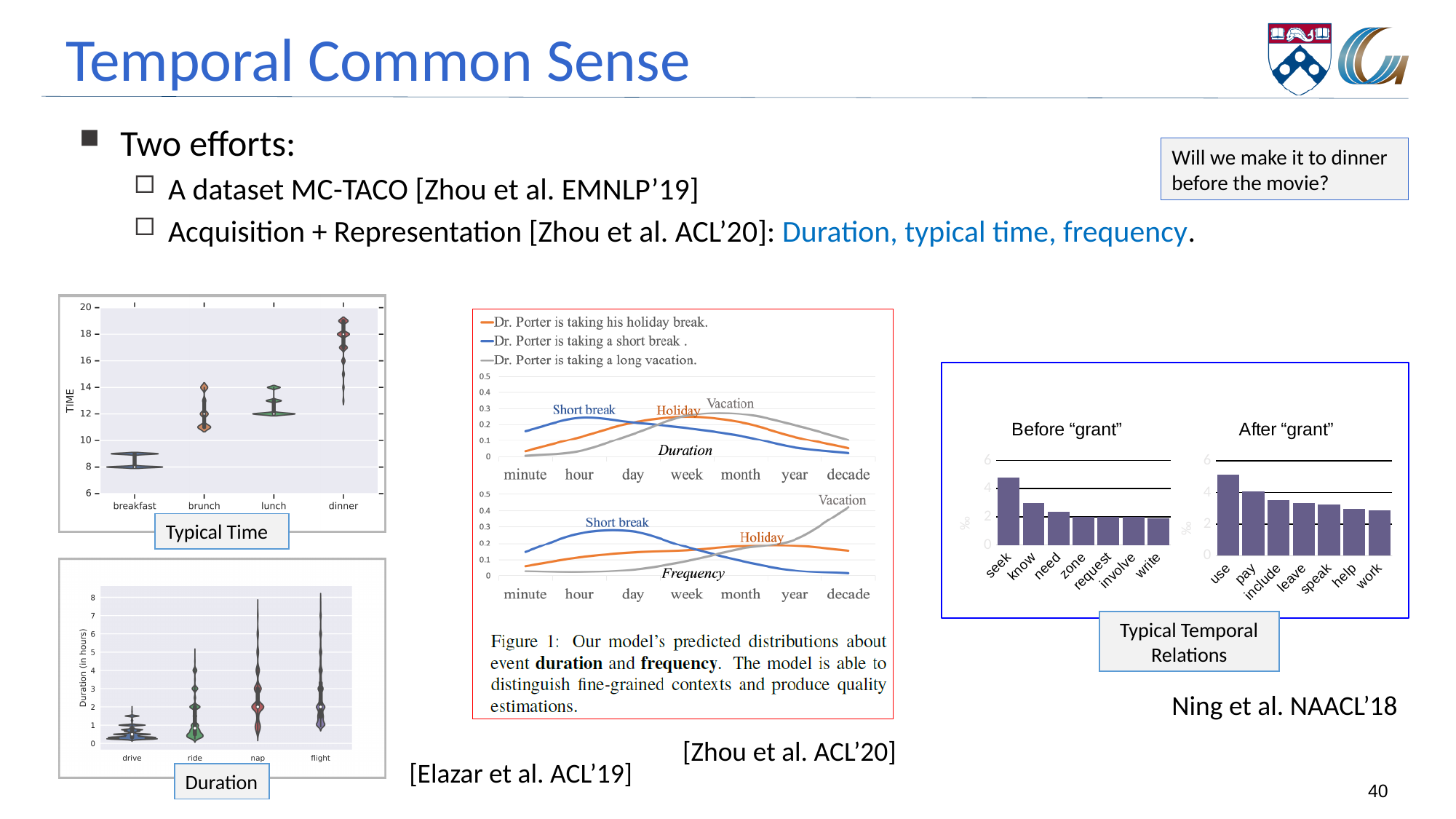
What kind of chart is the Before "grant" chart? bar chart How many categories are shown on the x axis of the Duration chart (bottom left)? 4 How many series does the legend of the Duration/Frequency line chart (Figure 1) list? 3 How many points are on the x axis of the Duration line chart in Figure 1? 7 In the Before "grant" bar chart, is the value for seek greater or less than 4? greater How many categories are shown on the x axis of the Before "grant" bar chart? 7 In the Typical Time chart, which category has the lowest time values? breakfast In the After "grant" bar chart, is the value for work greater or less than 4? less In the Typical Time chart, which category has the highest time values? dinner In the After "grant" bar chart, which is larger, the value for use or the value for pay? use In the Before "grant" bar chart, which category has the highest bar? seek In the After "grant" bar chart, which category has the highest bar? use